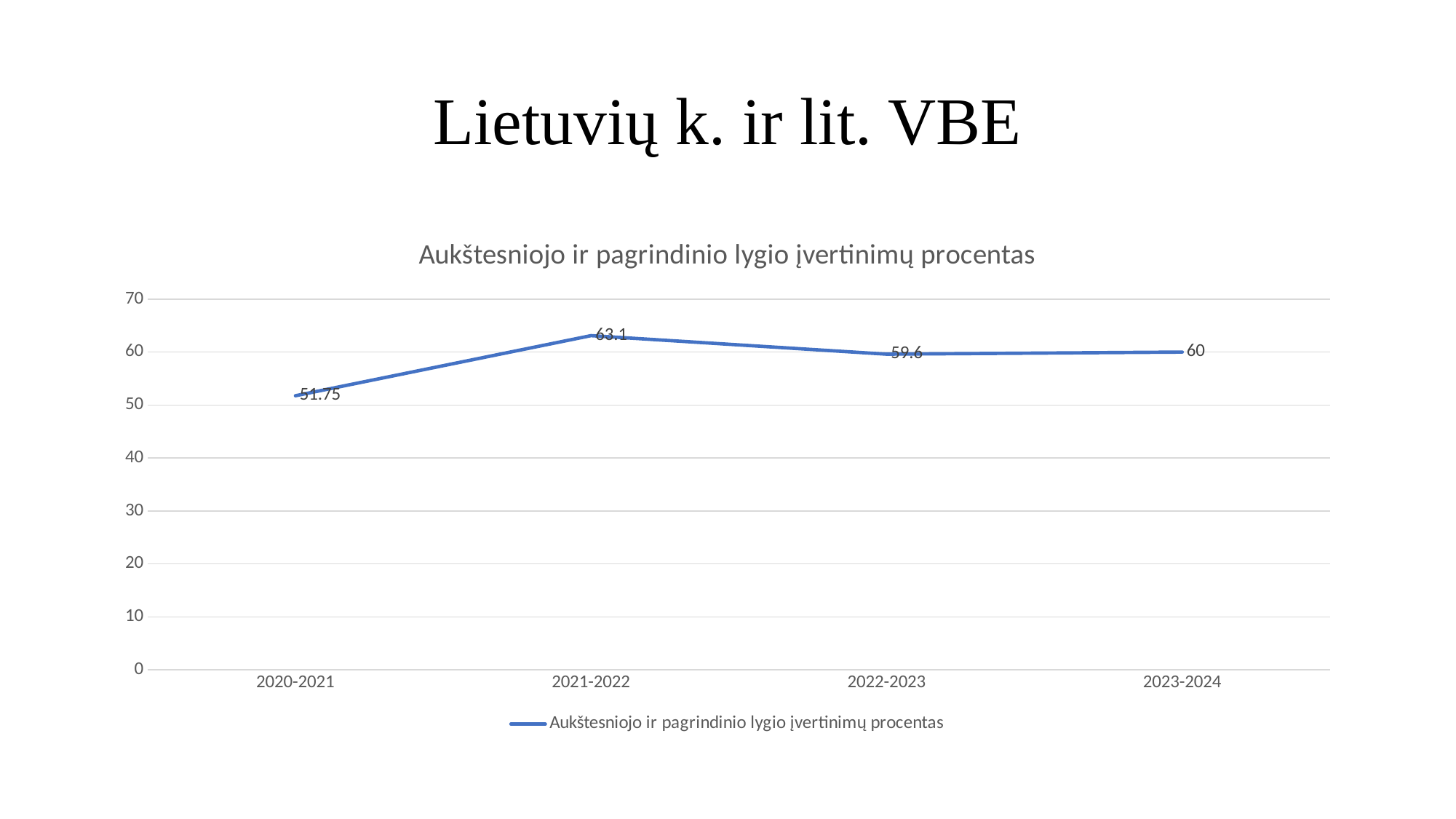
Which is larger, the value for 2021-2022 or the value for 2022-2023? 2021-2022 What is the value for 2020-2021? 51.75 What is the title of the chart? Aukštesniojo ir pagrindinio lygio įvertinimų procentas What is the value for 2022-2023? 59.6 Which school year has the highest value? 2021-2022 What is the difference between the values for 2021-2022 and 2020-2021? 11.35 Which school year has the lowest value? 2020-2021 What is the value for 2023-2024? 60 What kind of chart is shown? line chart Is the value for 2020-2021 greater or less than 60? less How many school years are plotted on the x axis? 4 What is the value for 2021-2022? 63.1